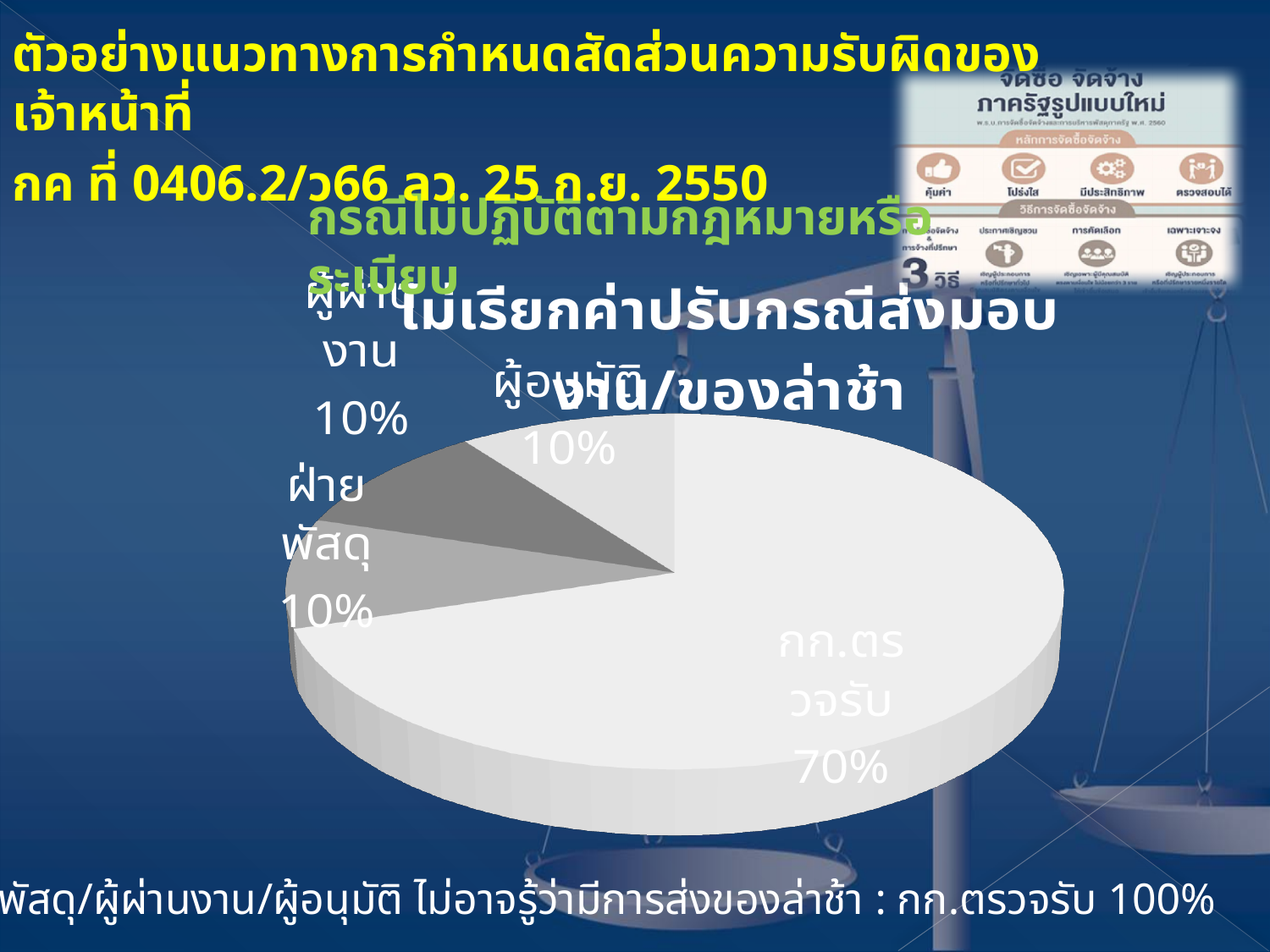
Which category has the largest slice of the pie? กก.ตรวจรับ What share of the pie does ผู้อนุมัติ have? 10% What is the title of the pie chart? ไม่เรียกค่าปรับกรณีส่งมอบงาน/ของล่าช้า What share of the pie does ฝ่ายพัสดุ have? 10% What share of the pie does กก.ตรวจรับ have? 70% What is the difference between the share of กก.ตรวจรับ and the share of ฝ่ายพัสดุ? 60% What share of the pie does ผู้ผ่านงาน have? 10% How many slices does the pie chart have? 4 What is the combined share of ฝ่ายพัสดุ, ผู้ผ่านงาน and ผู้อนุมัติ? 30% What kind of chart is shown on the slide? pie chart Which is larger, the share of กก.ตรวจรับ or the share of ผู้อนุมัติ? กก.ตรวจรับ